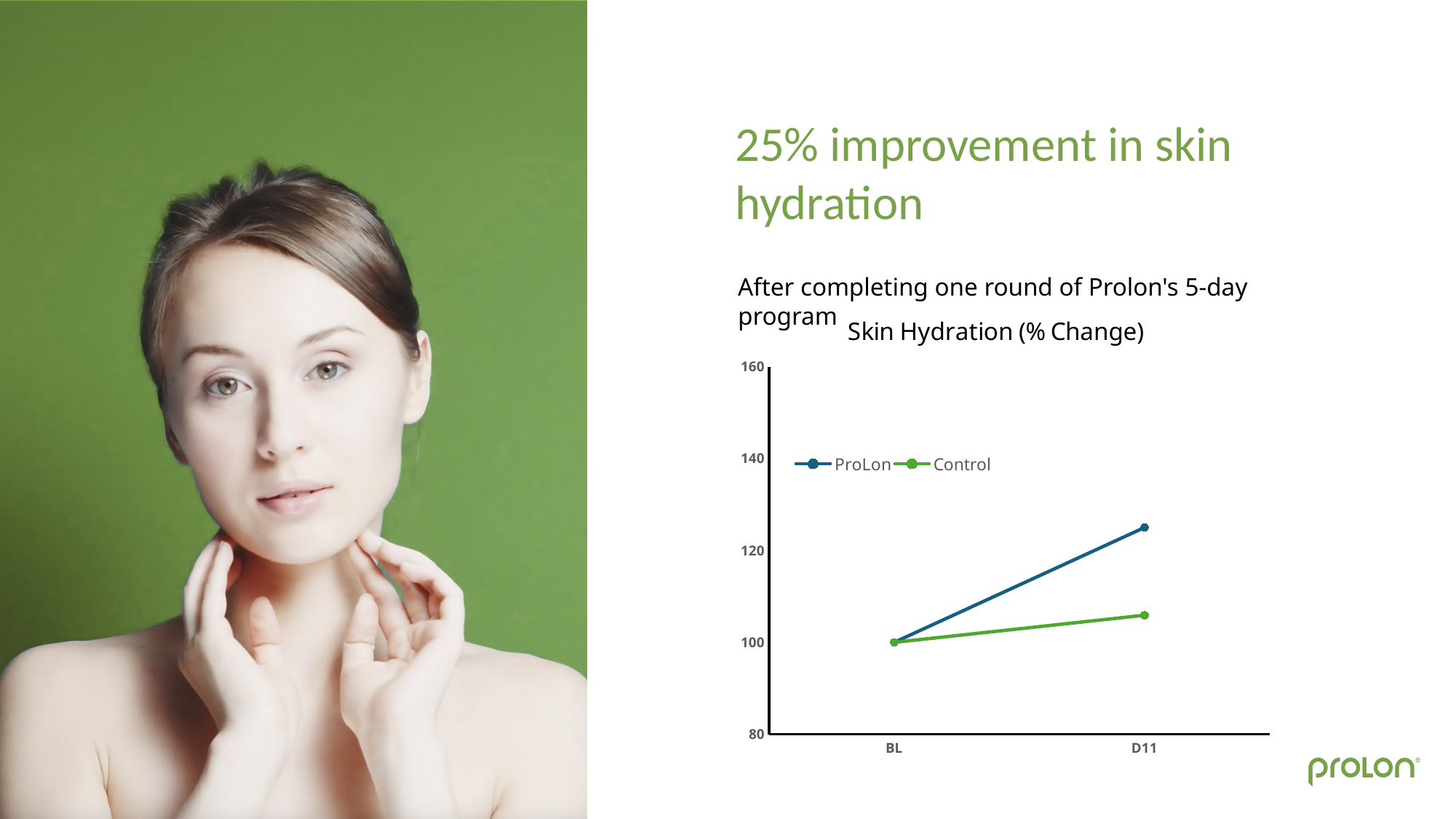
What kind of chart is shown on the slide? line chart What colour is the Control line in the chart? green What is the value for Control at BL? 100 Is the value for ProLon at D11 greater or less than 120? greater How many points are on the x axis of the chart? 2 How many series does the legend of the chart list? 2 Does the Control line rise or fall from BL to D11? rise Which series has the higher value at D11, ProLon or Control? ProLon Does the ProLon line rise or fall from BL to D11? rise What is the title of the chart? Skin Hydration (% Change) What is the value for ProLon at BL? 100 Is the value for Control at D11 greater or less than 120? less